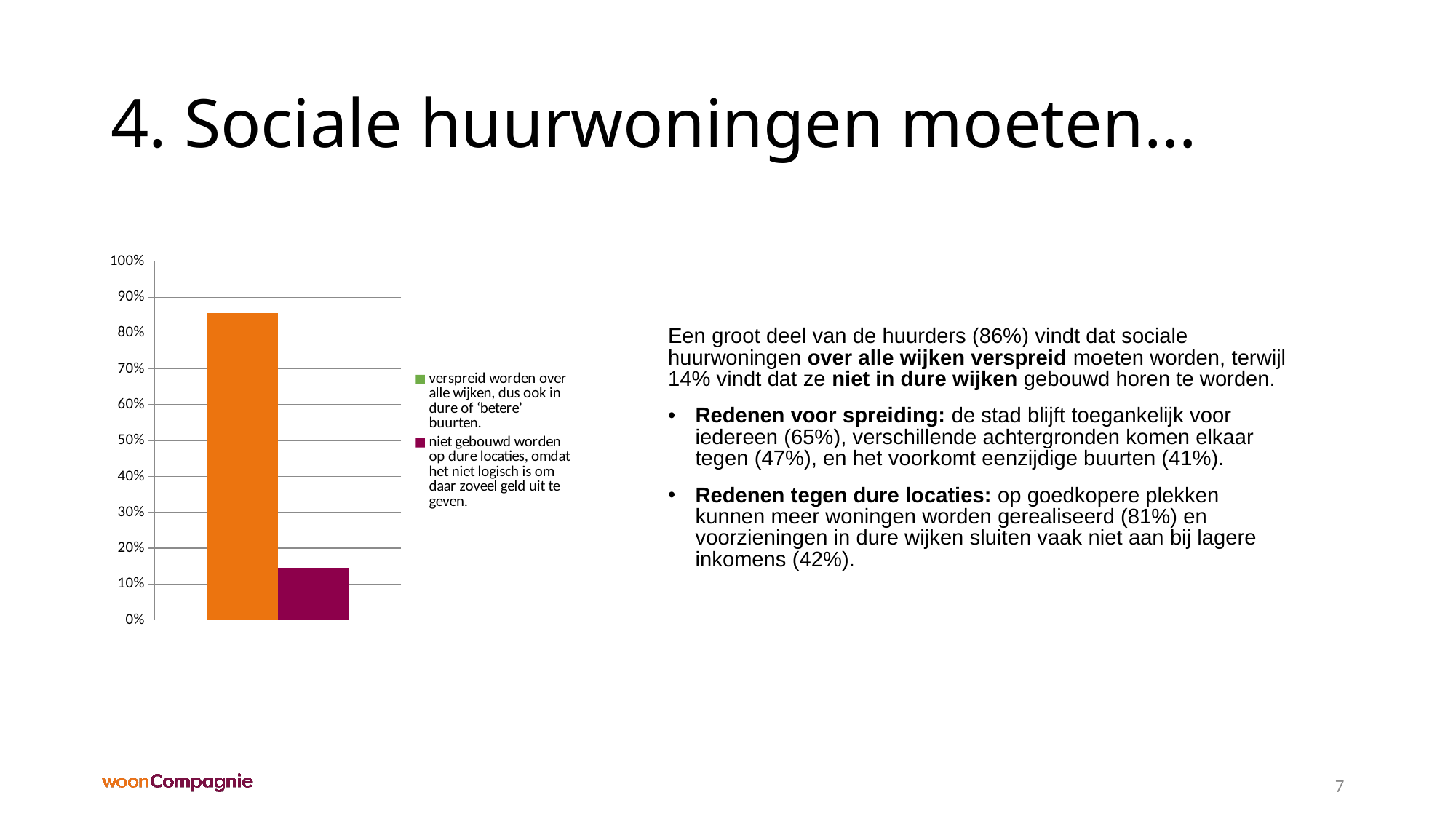
Is the value for 'verspreid worden over alle wijken' greater or less than 80%? greater How many bars are plotted in the chart? 2 Is the value for 'verspreid worden over alle wijken' greater or less than 90%? less Which series has the lowest bar in the chart? niet gebouwd worden op dure locaties, omdat het niet logisch is om daar zoveel geld uit te geven Is the value for 'niet gebouwd worden op dure locaties' greater or less than 10%? greater Which bar is taller: 'verspreid worden over alle wijken' or 'niet gebouwd worden op dure locaties'? verspreid worden over alle wijken What is the interval between tick marks on the chart's vertical axis? 10% What is the highest value shown on the chart's vertical axis? 100% Which series has the highest bar in the chart? verspreid worden over alle wijken, dus ook in dure of 'betere' buurten What kind of chart is shown on the slide? bar chart How many series does the chart legend list? 2